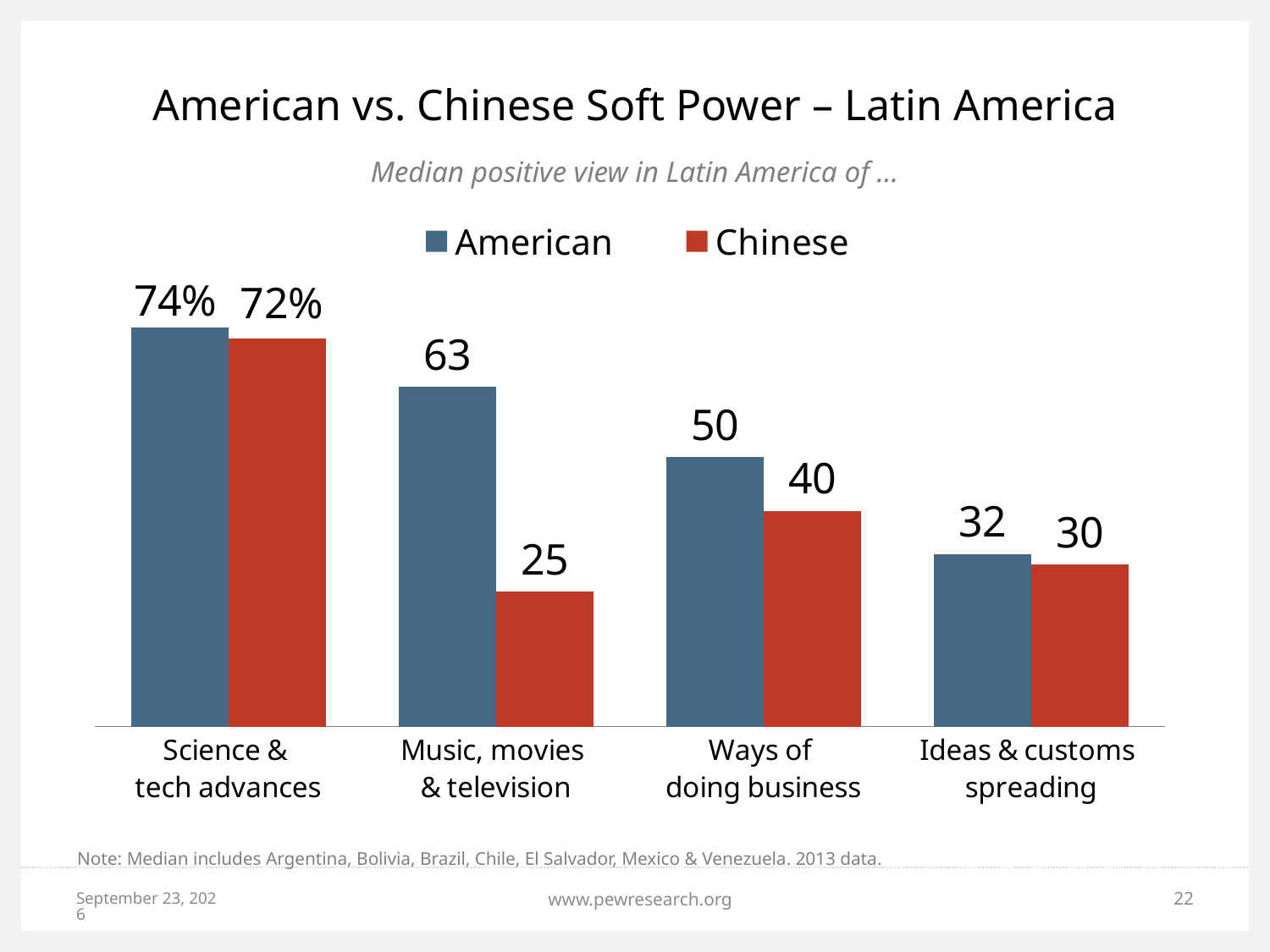
Which category has the highest American value? Science & tech advances What is the Chinese value for Music, movies & television? 25 Which category has the lowest Chinese value? Music, movies & television What is the difference between the American and Chinese values for Music, movies & television? 38 How many series does the legend list? 2 How many categories are shown on the x axis? 4 What is the American value for Ideas & customs spreading? 32 What kind of chart is shown on the slide? Bar chart Which is larger for Ways of doing business, the American or the Chinese value? American What is the American value for Science & tech advances? 74% Do the American values rise or fall from left to right across the categories? Fall What is the Chinese value for Ways of doing business? 40